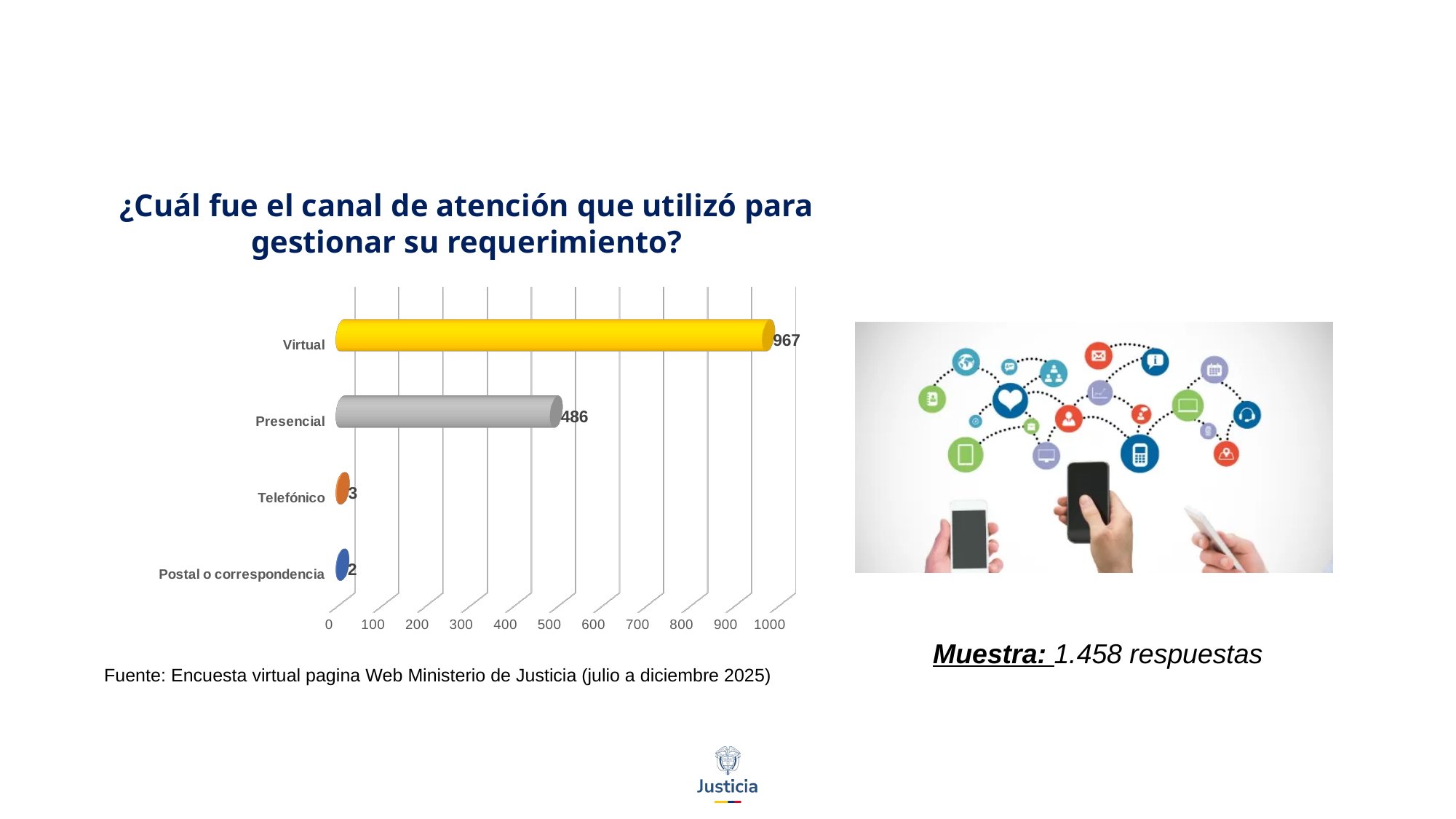
What is the value for Presencial? 486 What is the value for Virtual? 967 What is the title of the chart? ¿Cuál fue el canal de atención que utilizó para gestionar su requerimiento? Which is larger, the value for Presencial or the value for Telefónico? Presencial How many categories are shown in the chart? 4 What kind of chart is shown on the slide? bar chart Is the value for Presencial greater or less than 400? greater Which category has the highest value? Virtual What is the value for Telefónico? 3 What is the value for Postal o correspondencia? 2 Which category has the lowest value? Postal o correspondencia What is the difference between the values for Virtual and Presencial? 481